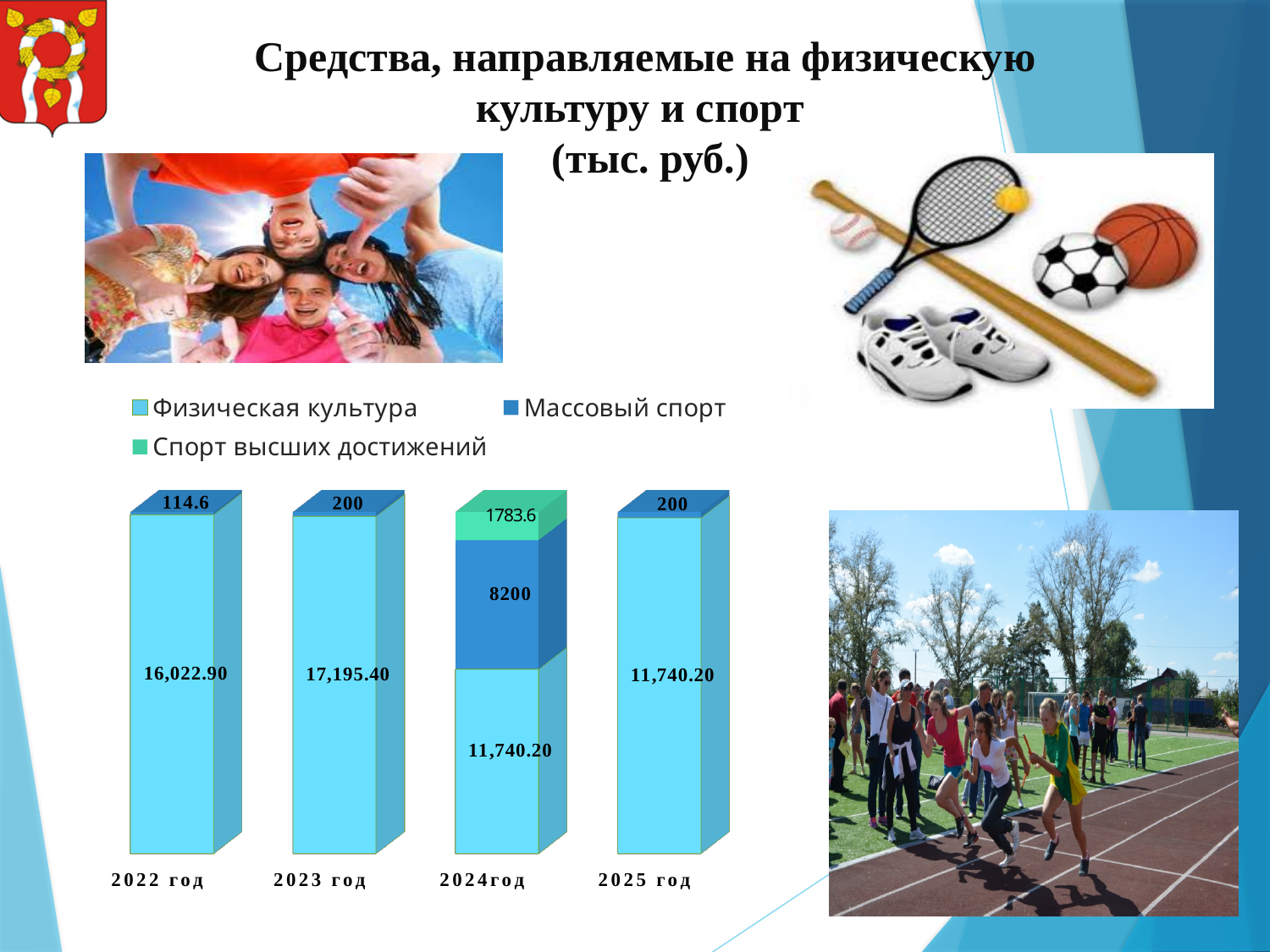
How many years are shown on the x axis? 4 What is the value for Спорт высших достижений in 2024год? 1783.6 In which year is the value for Массовый спорт the lowest? 2022 год What is the difference between the Физическая культура values for 2023 год and 2022 год? 1,172.50 What is the value for Массовый спорт in 2022 год? 114.6 What is the value for Массовый спорт in 2024год? 8200 In which year is the value for Физическая культура the highest? 2023 год What is the total of the stacked bar for 2024год? 21,723.8 What is the value for Физическая культура in 2022 год? 16,022.90 Which is larger: the Массовый спорт value for 2024год or for 2025 год? 2024год How many series does the legend list? 3 What kind of chart is shown on the slide? Stacked bar chart